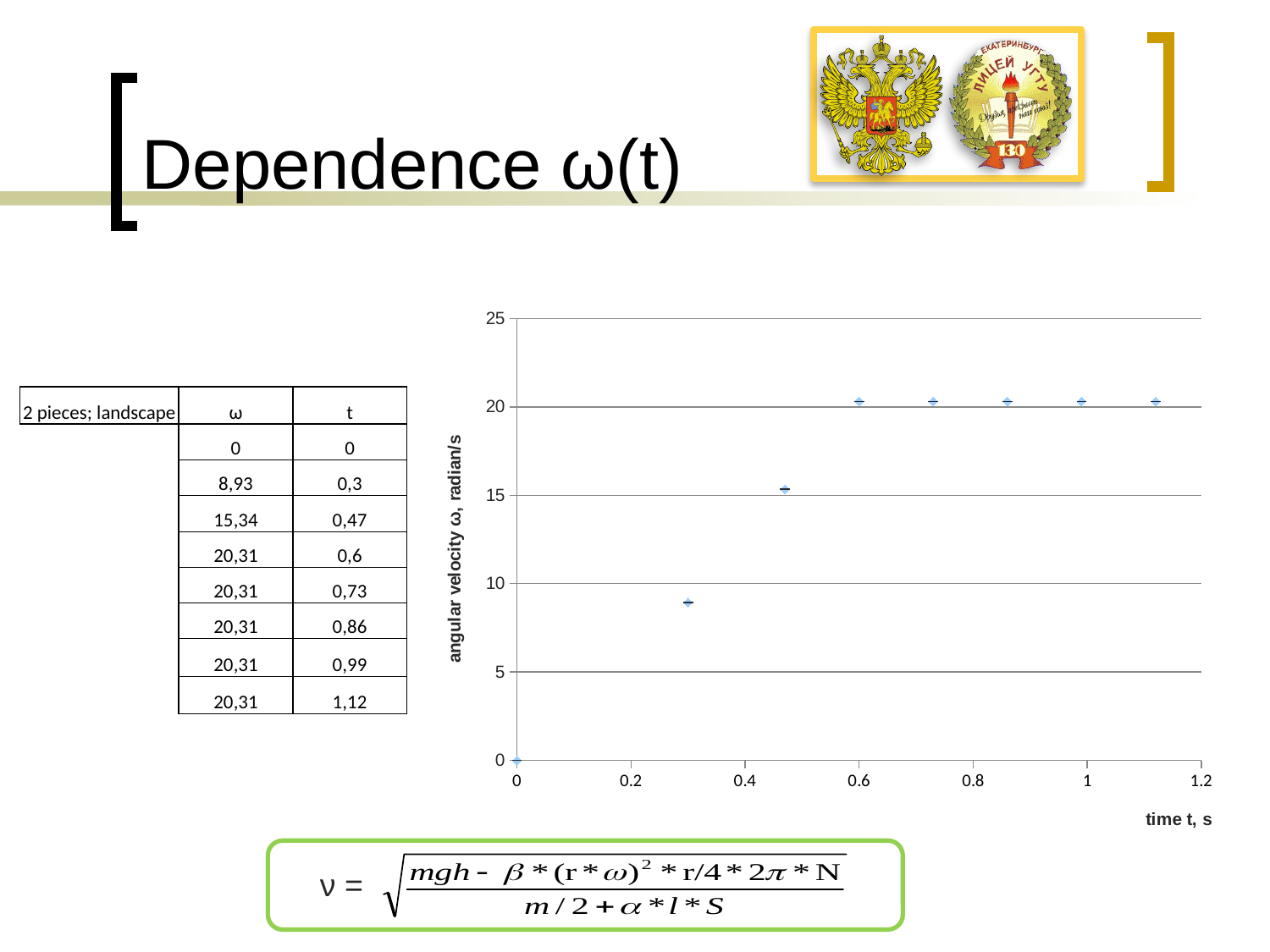
How many data points are plotted on the chart? 8 What is the label of the vertical axis of the chart? angular velocity ω, radian/s What kind of chart is shown on the slide? scatter chart Which is larger, the angular velocity at t = 0,47 s or at t = 0,6 s? t = 0,6 s Is the plotted angular velocity at t = 0.47 s greater or less than 15? greater According to the table, what is the angular velocity ω at t = 0,47 s? 15,34 How does the angular velocity change as time increases along the x axis? rises, then stays constant at 20,31 What is the highest angular velocity value reached in the data? 20,31 What is the label of the horizontal axis of the chart? time t, s According to the table, what is the angular velocity ω at t = 0,3 s? 8,93 Is the plotted angular velocity at t = 0.3 s greater or less than 10? less What is the difference between the angular velocity at t = 0,6 s and at t = 0,47 s? 4,97